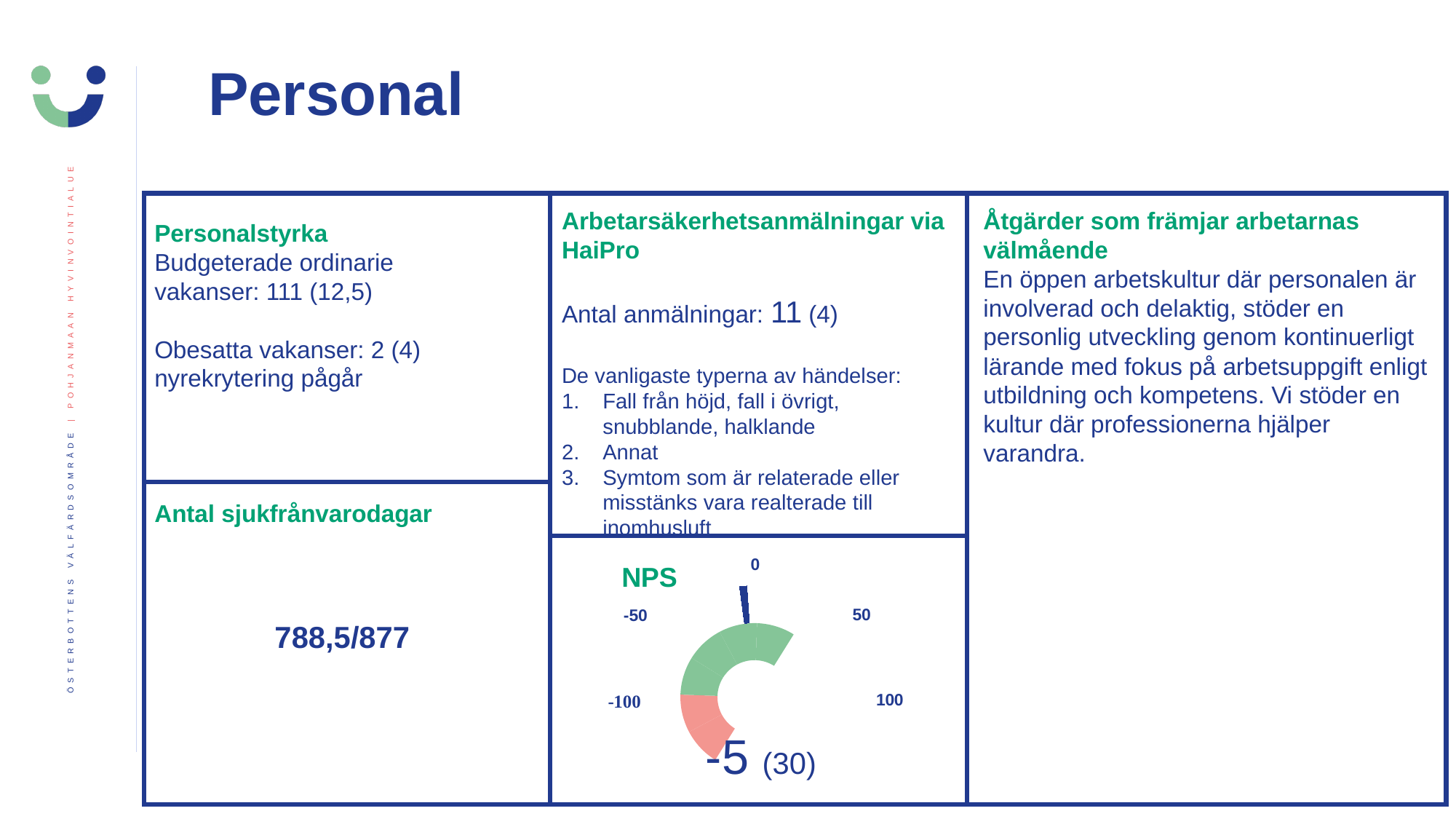
What is the NPS value shown on the gauge chart? -5 What is the title of the gauge chart? NPS How many scale labels are shown around the NPS gauge? 5 What number is shown in parentheses next to the NPS value on the gauge chart? 30 What two colours are used for the segments of the NPS gauge? green and red What kind of chart is used to display the NPS? gauge chart Is the NPS value on the gauge greater or less than 0? less Is the NPS value on the gauge greater or less than -50? greater What is the lowest value labelled on the NPS gauge scale? -100 What is the highest value labelled on the NPS gauge scale? 100